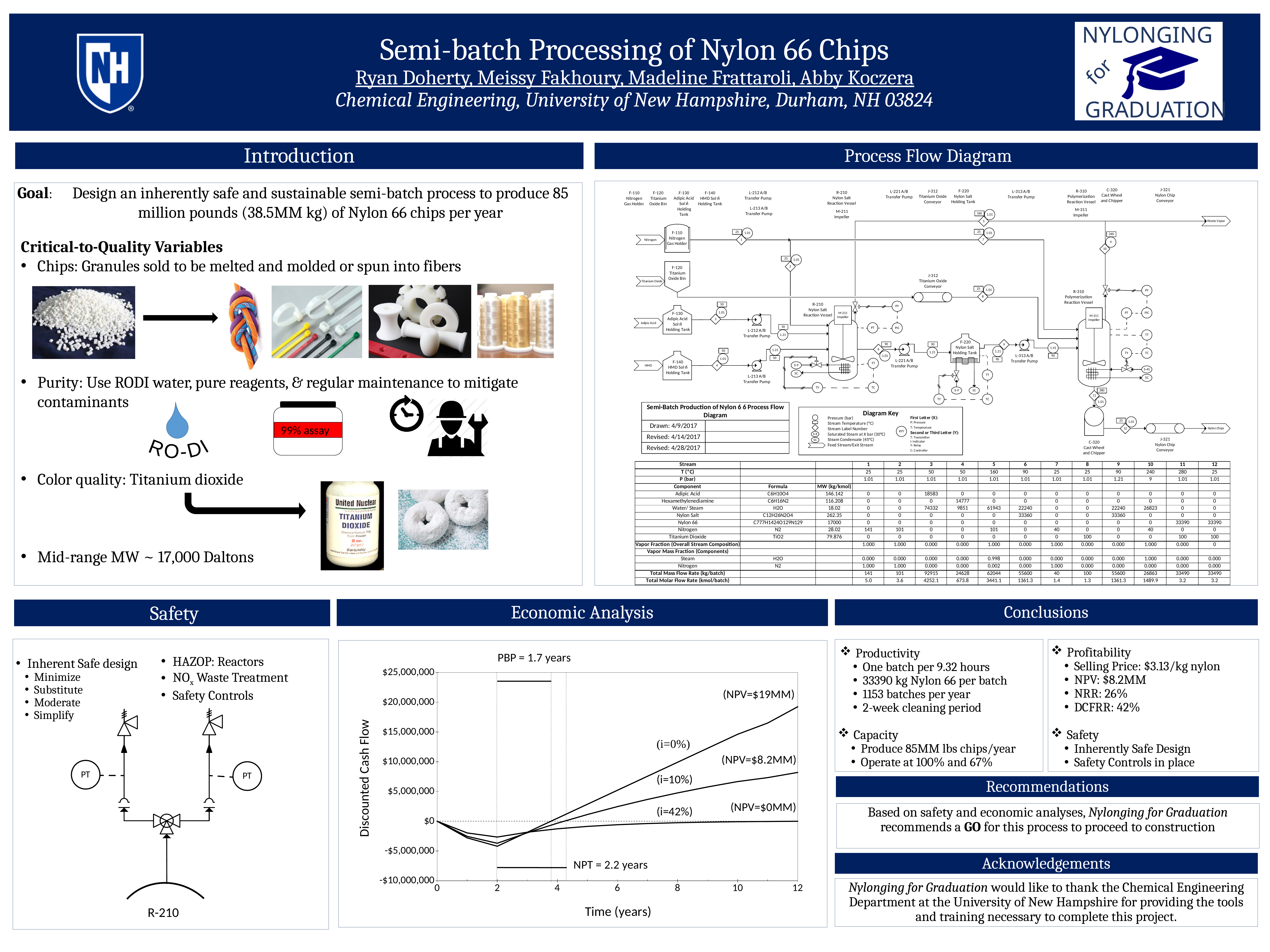
How many discounted cash flow lines are plotted on the Economic Analysis chart? 3 On the Economic Analysis chart, is the discounted cash flow of the i=10% line at year 12 greater or less than $10,000,000? less Which interest rate line on the Economic Analysis chart has the lowest NPV? i=42% On the Economic Analysis chart, what payback period (PBP) is annotated? 1.7 years On the Economic Analysis chart, what is the difference between the NPV of the i=0% line and the NPV of the i=10% line? $10.8MM On the Economic Analysis chart, what NPV is labelled for the i=42% line? $0MM On the Economic Analysis chart, is the discounted cash flow of the i=0% line at year 12 greater or less than $15,000,000? greater Which interest rate line on the Economic Analysis chart has the highest NPV? i=0% On the Economic Analysis chart, what NPV is labelled for the i=10% line? $8.2MM What is the x-axis label of the Economic Analysis chart? Time (years) What kind of chart is shown in the Economic Analysis section? line chart On the Economic Analysis chart, what NPV is labelled for the i=0% line? $19MM